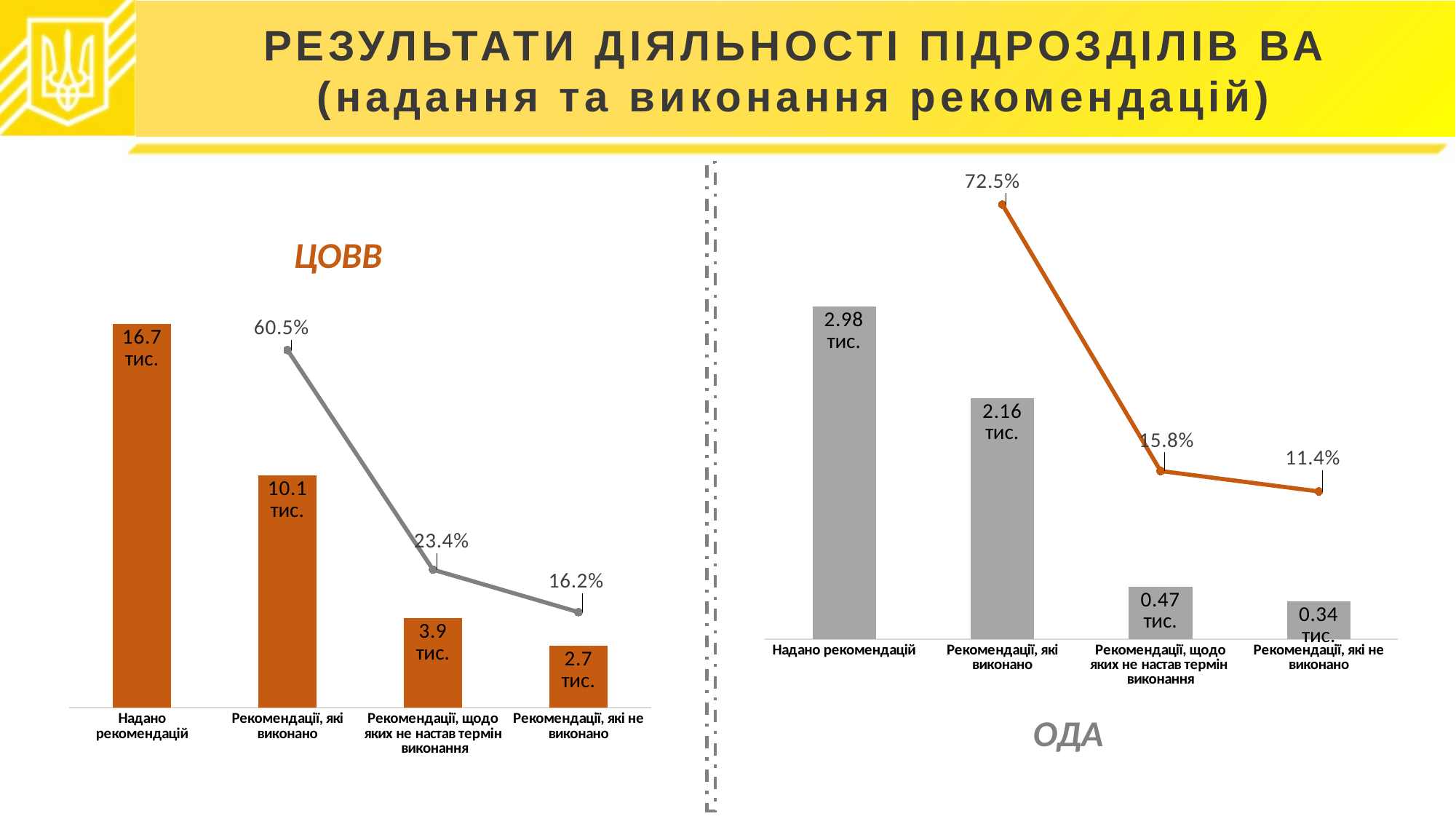
In the ОДА chart, what is the value of the bar for "Рекомендації, які не виконано"? 0.34 тис. What colour are the bars in the ОДА chart? grey In the ЦОВВ chart, what percentage is shown on the line for "Рекомендації, які виконано"? 60.5% How many categories are shown on the x axis of the ОДА chart? 4 In the ОДА chart, which category has the highest bar? Надано рекомендацій In the ЦОВВ chart, what is the value of the bar for "Надано рекомендацій"? 16.7 тис. Which is larger: the "Рекомендації, які виконано" percentage in the ЦОВВ chart or in the ОДА chart? ОДА In the ЦОВВ chart, which category has the lowest bar? Рекомендації, які не виконано In the ОДА chart, what percentage is shown on the line for "Рекомендації, щодо яких не настав термін виконання"? 15.8% Do the bar values in the ЦОВВ chart rise or fall from left to right along the x axis? fall In the ОДА chart, what is the difference between the line values for "Рекомендації, які виконано" and "Рекомендації, які не виконано"? 61.1% In the ЦОВВ chart, what is the difference between the bars for "Надано рекомендацій" and "Рекомендації, які виконано"? 6.6 тис.